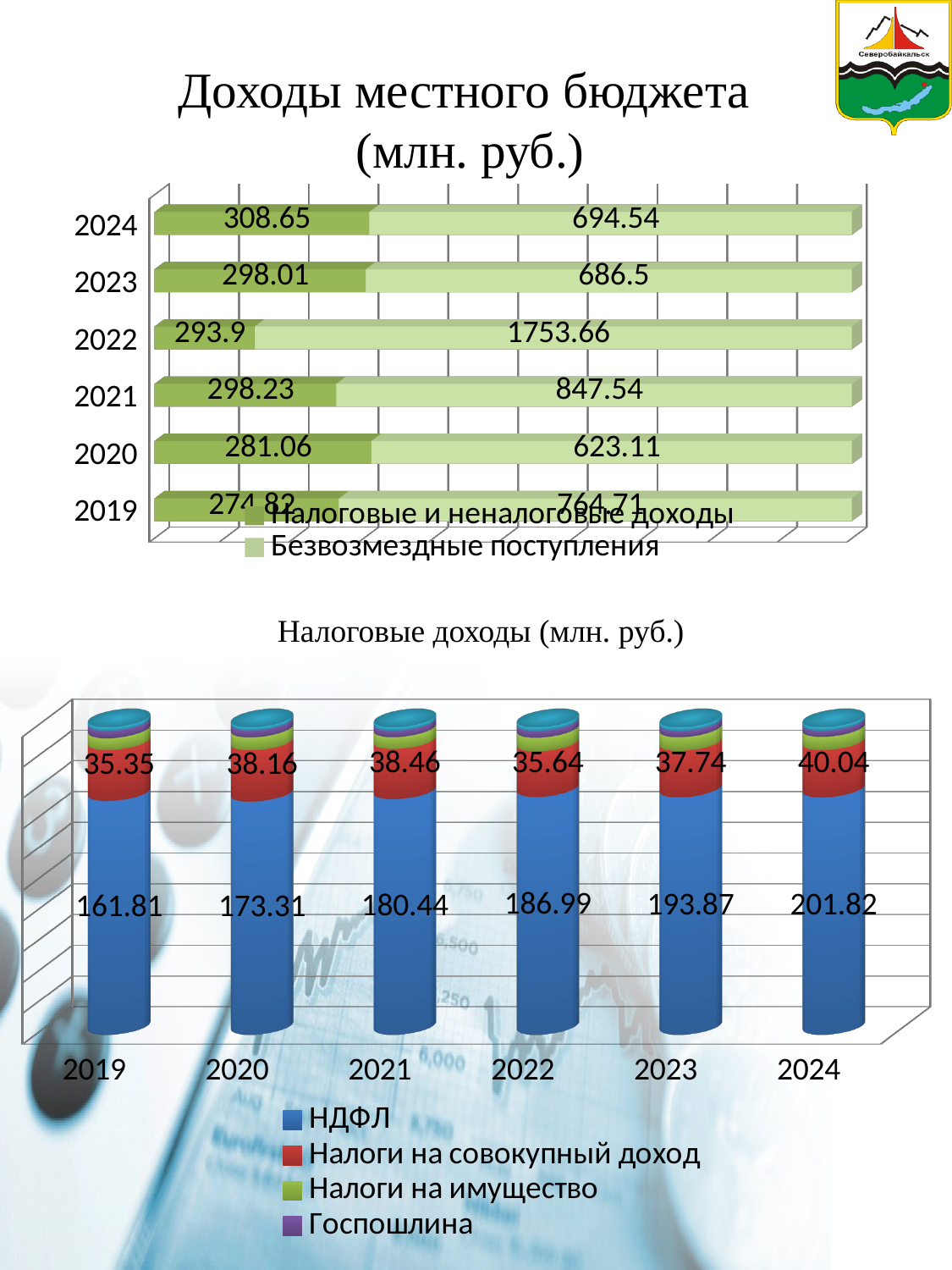
In the chart 'Доходы местного бюджета (млн. руб.)', what is the total of the two labelled values for 2024? 1003.19 In the chart 'Налоговые доходы (млн. руб.)', which year has the lowest НДФЛ value? 2019 In the chart 'Доходы местного бюджета (млн. руб.)', what is the difference between 'Безвозмездные поступления' in 2022 and in 2021? 906.12 In the chart 'Доходы местного бюджета (млн. руб.)', which year has the highest value of 'Безвозмездные поступления'? 2022 In the chart 'Доходы местного бюджета (млн. руб.)', what is the value of 'Налоговые и неналоговые доходы' for 2024? 308.65 In the chart 'Доходы местного бюджета (млн. руб.)', how many series does the legend list? 2 In the chart 'Налоговые доходы (млн. руб.)', what is the value of 'Налоги на совокупный доход' for 2024? 40.04 In the chart 'Налоговые доходы (млн. руб.)', does the НДФЛ value rise or fall from 2019 to 2024? rise In the chart 'Доходы местного бюджета (млн. руб.)', what is the value of 'Безвозмездные поступления' for 2022? 1753.66 In the chart 'Налоговые доходы (млн. руб.)', what is the difference between the НДФЛ values for 2024 and 2019? 40.01 In the chart 'Налоговые доходы (млн. руб.)', how many series does the legend list? 4 In the chart 'Налоговые доходы (млн. руб.)', what is the value of НДФЛ for 2021? 180.44